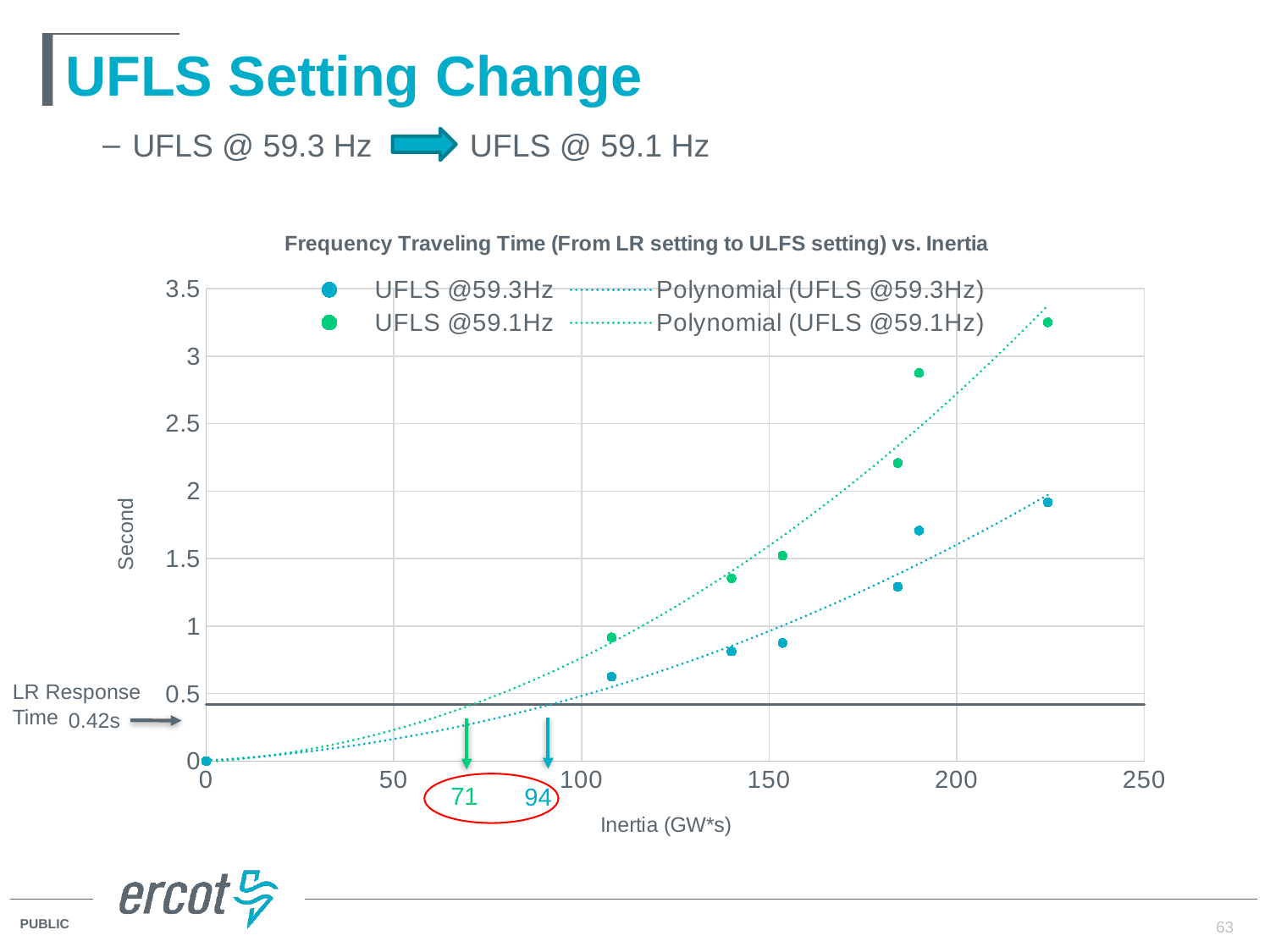
At the highest inertia plotted (around 225 GW*s), which series has the larger traveling time, UFLS @59.3Hz or UFLS @59.1Hz? UFLS @59.1Hz Is the UFLS @59.1Hz data point near an inertia of 190 GW*s greater or less than 2.5 seconds? greater What kind of chart is shown on the slide? scatter chart How many entries does the chart legend list? 4 What LR Response Time value is marked by the horizontal line on the chart? 0.42s What inertia value is annotated where the UFLS @59.1Hz polynomial curve crosses the LR Response Time line? 71 What is the title of the chart? Frequency Traveling Time (From LR setting to ULFS setting) vs. Inertia What is the label of the vertical axis of the chart? Second Is the highest UFLS @59.3Hz data point greater or less than 2 seconds? less Is the highest UFLS @59.1Hz data point greater or less than 3 seconds? greater What inertia value is annotated where the UFLS @59.3Hz polynomial curve crosses the LR Response Time line? 94 Do the frequency traveling time values rise or fall as inertia increases along the x axis? rise